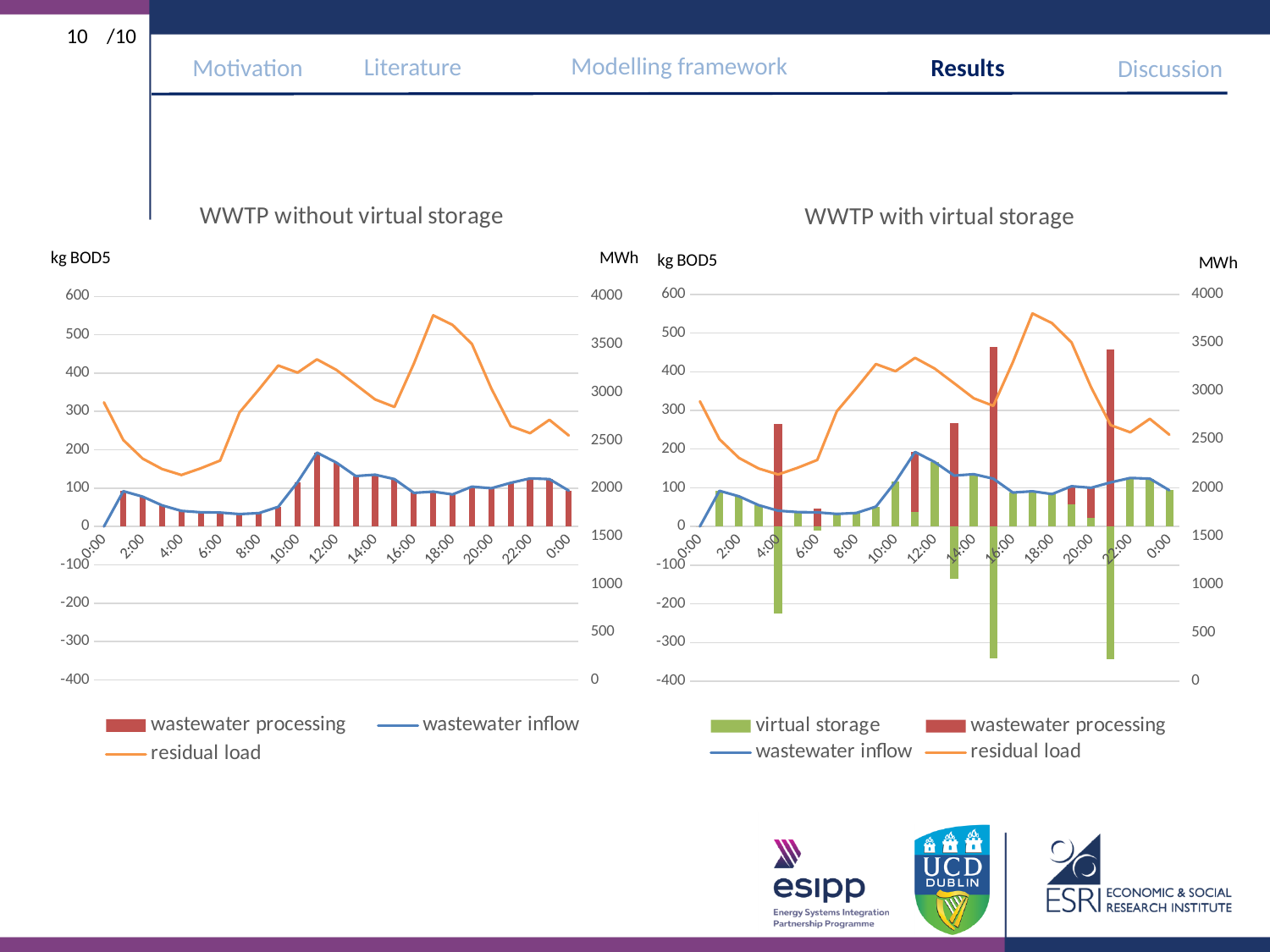
In the 'WWTP without virtual storage' chart, is the residual load at 4:00 greater or less than 2500 MWh? less In the 'WWTP with virtual storage' chart, what colour are the virtual storage bars? green How many time labels are shown on the x axis of the 'WWTP without virtual storage' chart? 13 In the 'WWTP with virtual storage' chart, what kind of chart is used to plot the virtual storage series? bar chart In the 'WWTP without virtual storage' chart, is the residual load at 18:00 greater or less than 3500 MWh? greater In the 'WWTP without virtual storage' chart, at which labelled time is the residual load lowest? 4:00 In the 'WWTP without virtual storage' chart, how many series does the legend list? 3 In the 'WWTP with virtual storage' chart, how many series does the legend list? 4 In the 'WWTP with virtual storage' chart, does the residual load rise or fall between 18:00 and 22:00? fall In the 'WWTP without virtual storage' chart, at which time does the residual load reach its highest value? 17:00